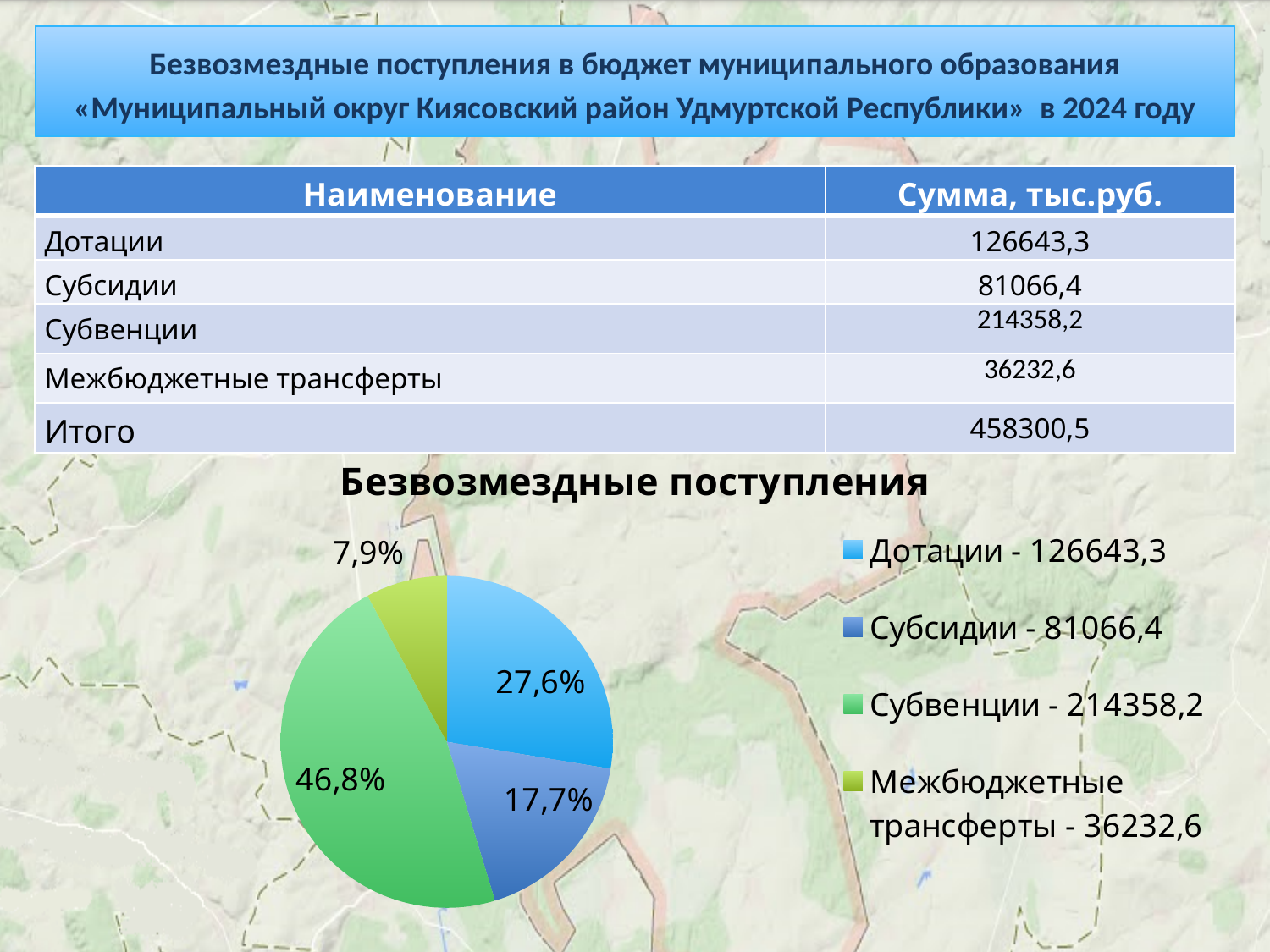
What share of the pie does Межбюджетные трансферты represent? 7,9% What share of the pie does Субвенции represent? 46,8% What is the title of the chart? Безвозмездные поступления How many slices does the pie chart have? 4 What share of the pie does Дотации represent? 27,6% Which category has the largest slice of the pie? Субвенции What is the difference in percentage points between the Субвенции slice and the Дотации slice? 19,2 What kind of chart is shown on the slide? pie chart Which category has the smallest slice of the pie? Межбюджетные трансферты Which is larger, the slice for Дотации or the slice for Субсидии? Дотации What value does the legend give for Субвенции? 214358,2